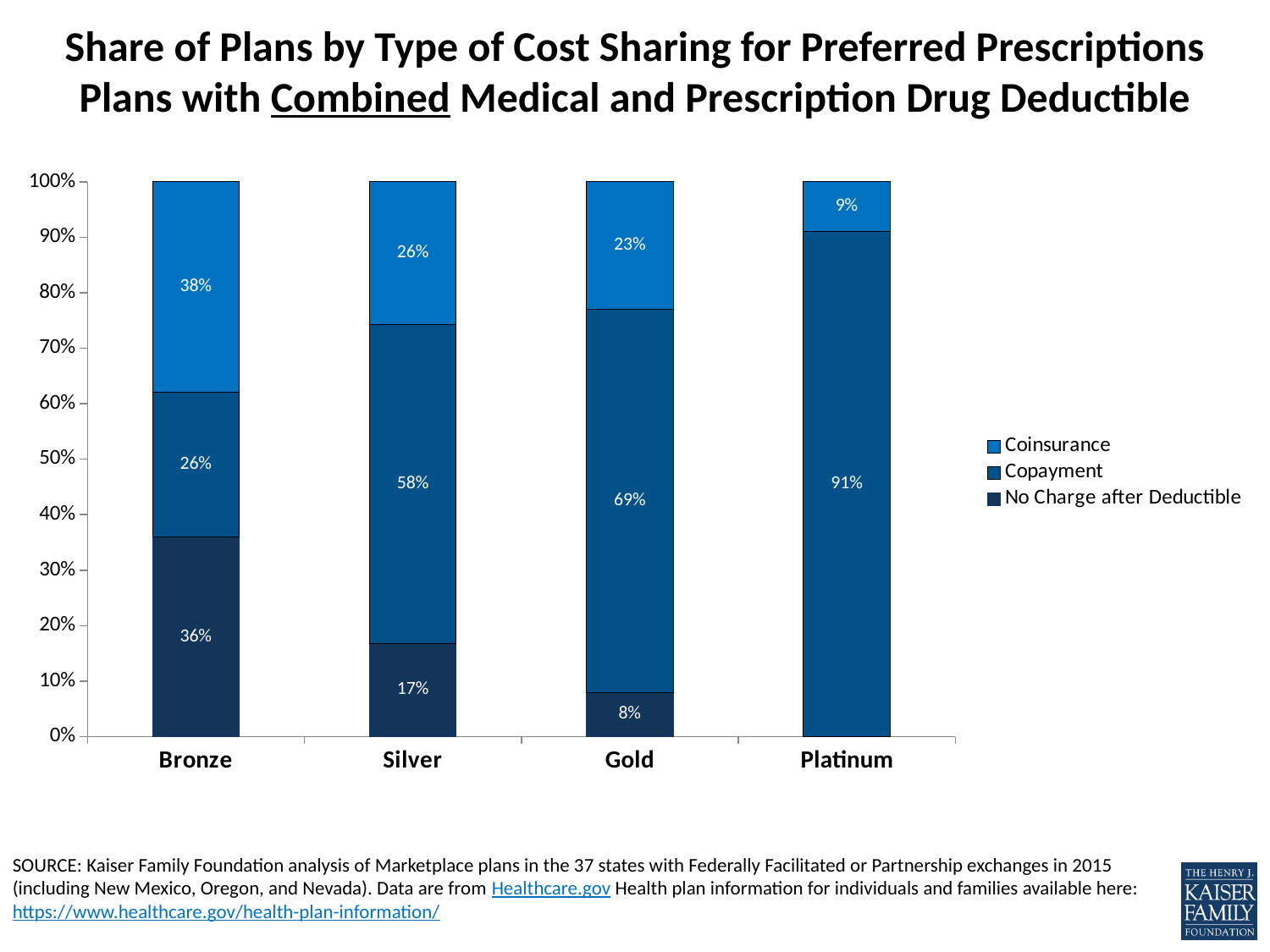
What is the Copayment share for Gold plans? 69% What is the Coinsurance share for Platinum plans? 9% What kind of chart is shown on the slide? Stacked bar chart How many series does the legend list? 3 Which is larger: the No Charge after Deductible share for Bronze or for Gold? Bronze How many plan types are shown on the x axis? 4 What is the difference between the Copayment share for Silver and the Copayment share for Bronze? 32 percentage points What share of Bronze plans use coinsurance for preferred prescriptions? 38% Which plan type has the lowest Coinsurance share? Platinum Does the Copayment share rise or fall moving from Bronze to Platinum along the x axis? Rise Which plan type has the highest Copayment share? Platinum What is the No Charge after Deductible share for Silver plans? 17%